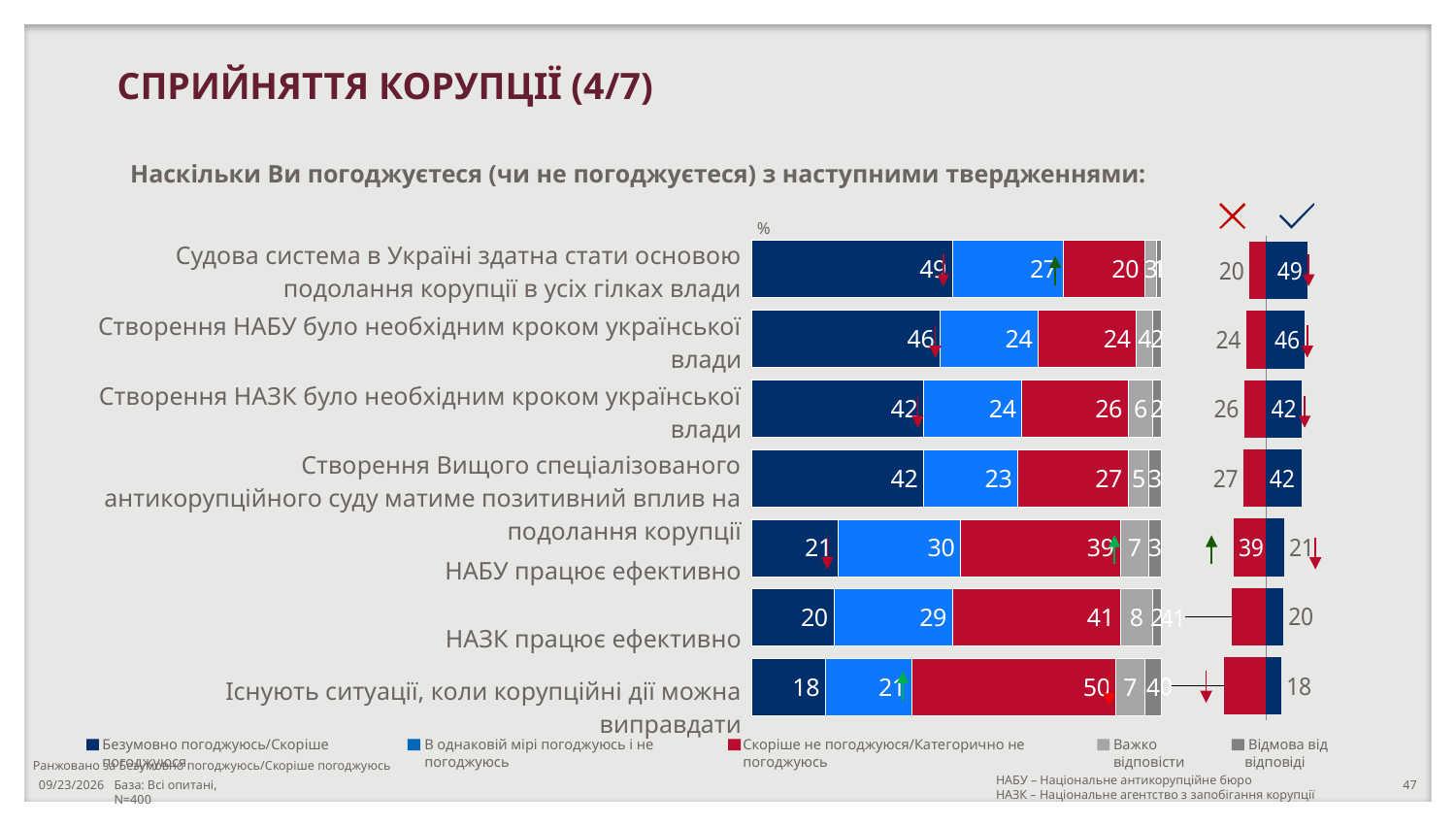
What is the value of "Безумовно погоджуюсь/Скоріше погоджуюсь" for the statement "Судова система в Україні здатна стати основою подолання корупції в усіх гілках влади"? 49 What question is the chart answering, according to the text above it? Наскільки Ви погоджуєтеся (чи не погоджуєтеся) з наступними твердженнями: What is the value of "В однаковій мірі погоджуюсь і не погоджуюсь" for the statement "НАБУ працює ефективно"? 30 What is the difference between the "Безумовно погоджуюсь/Скоріше погоджуюсь" values for "Судова система в Україні здатна стати основою подолання корупції в усіх гілках влади" and "Існують ситуації, коли корупційні дії можна виправдати"? 31 How many statements (categories) are plotted in the chart? 7 What kind of chart is shown on the slide? bar chart Which has the larger "Скоріше не погоджуюся/Категорично не погоджуюсь" value: "НАБУ працює ефективно" or "НАЗК працює ефективно"? НАЗК працює ефективно Which statement has the highest value for "Безумовно погоджуюсь/Скоріше погоджуюсь"? Судова система в Україні здатна стати основою подолання корупції в усіх гілках влади For the statement "Створення НАБУ було необхідним кроком української влади", what is the difference between the "Безумовно погоджуюсь/Скоріше погоджуюсь" value and the "Скоріше не погоджуюся/Категорично не погоджуюсь" value? 22 What is the value of "Скоріше не погоджуюся/Категорично не погоджуюсь" for the statement "Існують ситуації, коли корупційні дії можна виправдати"? 50 How many series does the chart legend list? 5 Which statement has the lowest value for "Безумовно погоджуюсь/Скоріше погоджуюсь"? Існують ситуації, коли корупційні дії можна виправдати